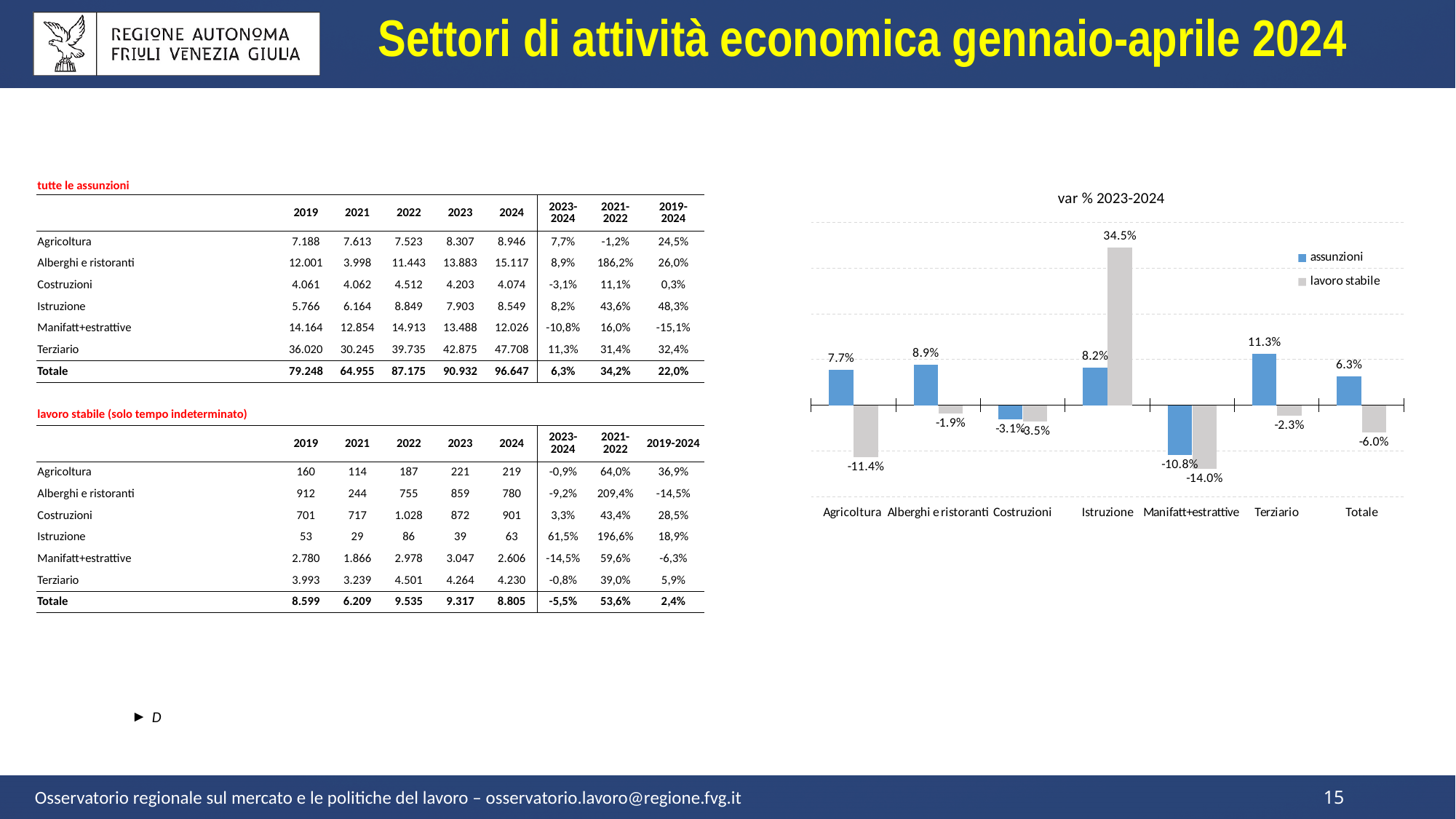
What is the value for assunzioni in Totale? 6.3% What is the value for assunzioni in Terziario? 11.3% What kind of chart is shown on the slide? bar chart What is the difference between the assunzioni and lavoro stabile values for Agricoltura? 19.1 percentage points How many categories are shown on the x axis of the chart? 7 What is the value for lavoro stabile in Manifatt+estrattive? -14.0% How many series does the chart legend list? 2 What is the title of the chart? var % 2023-2024 What is the value for lavoro stabile in Istruzione? 34.5% Which category has the lowest value for lavoro stabile? Manifatt+estrattive Which category has the highest value for assunzioni? Terziario Which is larger for Alberghi e ristoranti: the assunzioni value or the lavoro stabile value? assunzioni